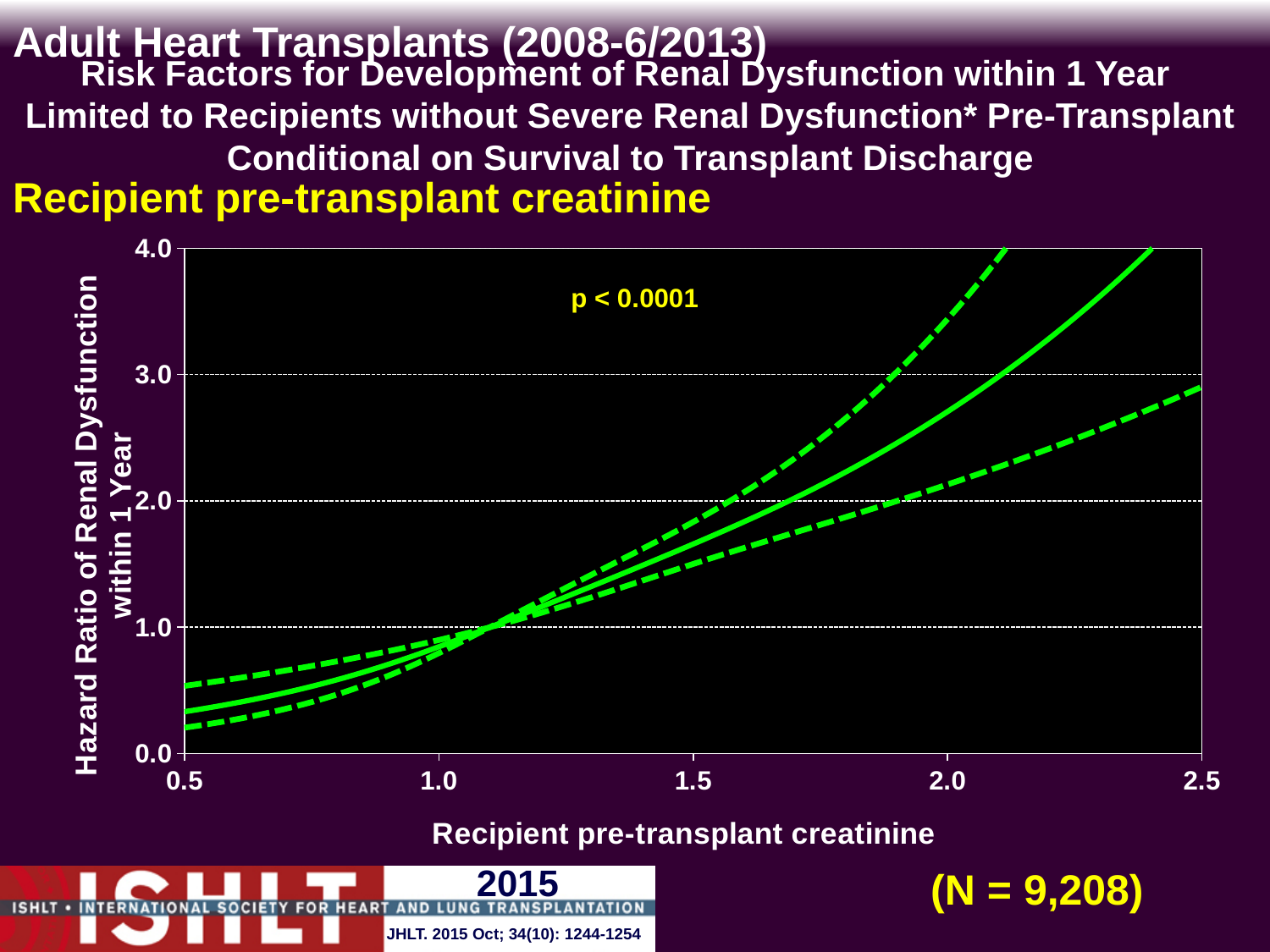
What is the highest value shown on the x axis of the chart? 2.5 How many lines (solid and dashed) are plotted on the chart? 3 Is the upper dashed line at a recipient pre-transplant creatinine of 2.0 greater or less than 3.0? greater Does the solid hazard ratio line rise or fall as recipient pre-transplant creatinine increases from 0.5 to 2.5? rise Is the solid-line hazard ratio at a recipient pre-transplant creatinine of 0.5 greater or less than 1.0? less What is the label of the x axis of the chart? Recipient pre-transplant creatinine What p-value is printed on the chart? p < 0.0001 Is the lower dashed line at a recipient pre-transplant creatinine of 2.5 greater or less than 2.0? greater What is the highest value shown on the y axis of the chart? 4.0 What kind of chart is shown on the slide? line chart